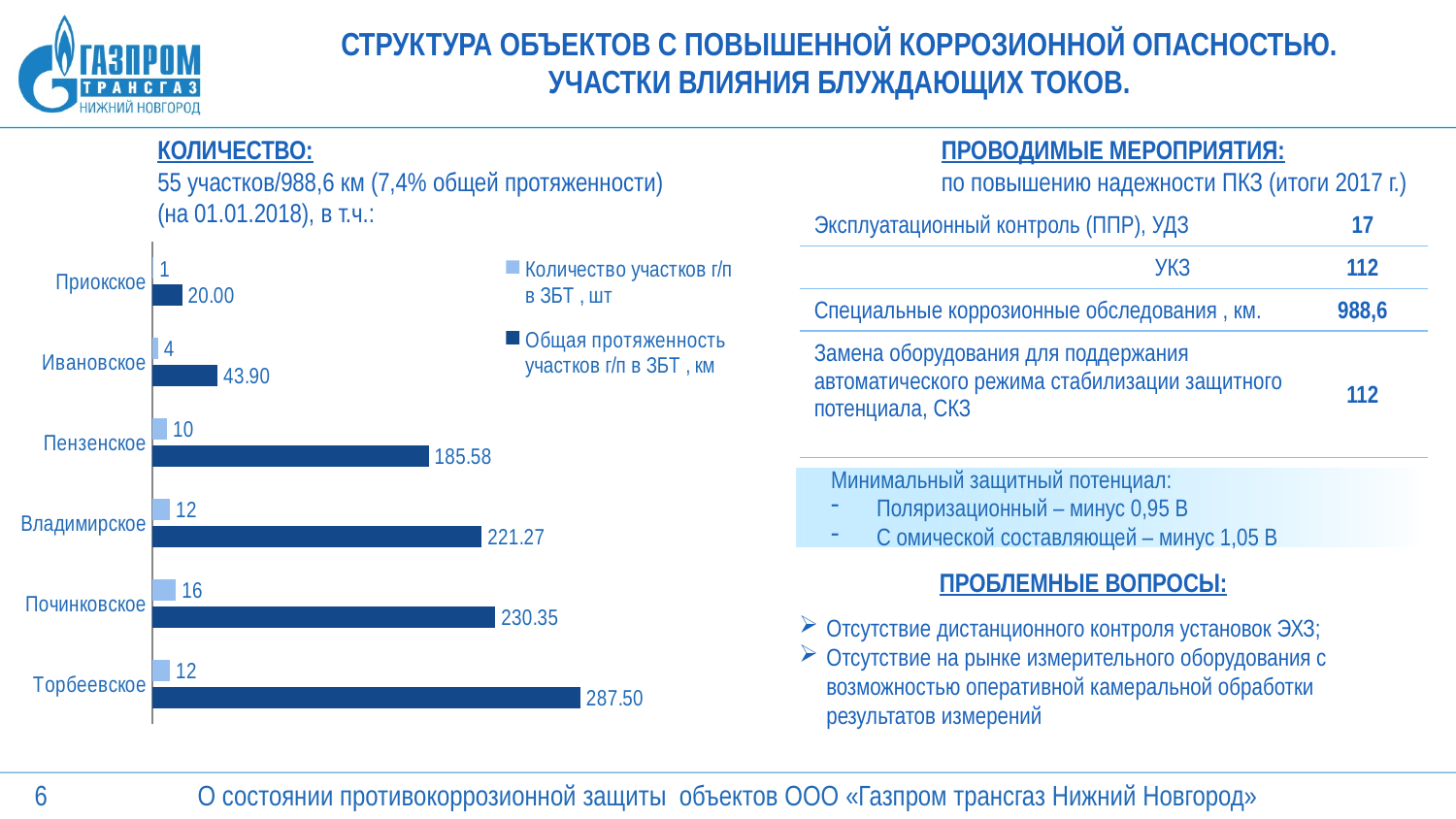
What is the difference in total length (km) between Торбеевское and Починковское? 57.15 What is the total length in km shown for Пензенское? 185.58 How many sections (Количество участков г/п в ЗБТ, шт) are shown for Починковское? 16 What type of chart is shown on the slide? Bar chart Which category has the lowest number of sections (Количество участков г/п в ЗБТ, шт)? Приокское Which category has the highest total length (Общая протяженность участков г/п в ЗБТ, км)? Торбеевское Which has a greater total length in km, Владимирское or Пензенское? Владимирское What is the total length of sections (Общая протяженность участков г/п в ЗБТ, км) for Торбеевское? 287.50 Which series is shown in dark blue in the chart legend? Общая протяженность участков г/п в ЗБТ, км What is the difference in number of sections between Починковское and Ивановское? 12 How many categories (branches) are shown on the bar chart? 6 How many series does the chart legend list? 2